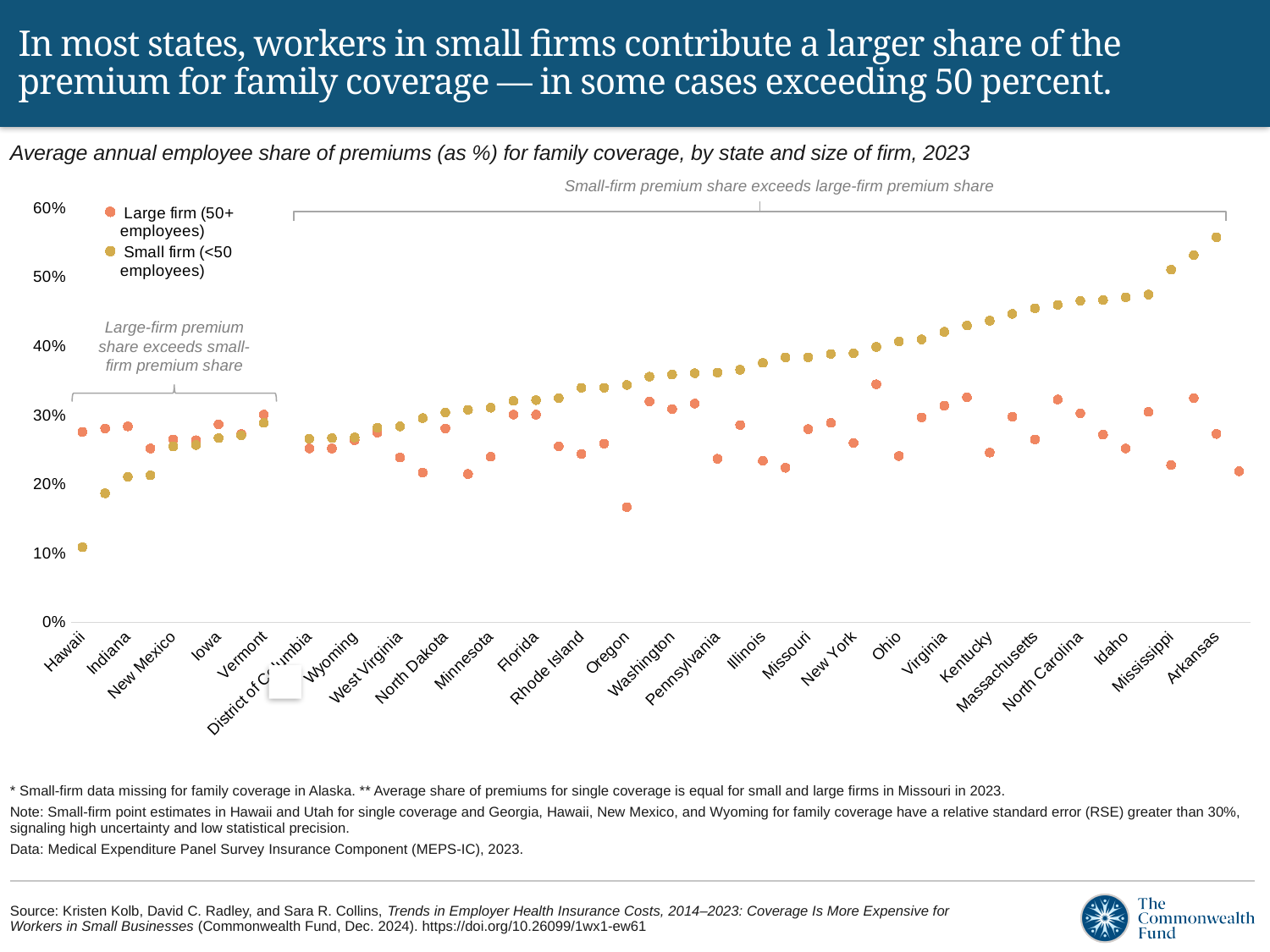
What does the annotation above the bracket spanning most of the chart say? Small-firm premium share exceeds large-firm premium share What kind of chart is shown on the slide? Scatter (dot) chart In Hawaii, which is larger: the large-firm premium share or the small-firm premium share? Large-firm premium share How many series does the legend list? 2 Is the small-firm premium share for Arkansas greater or less than 50%? greater Is the small-firm premium share for Hawaii greater or less than 20%? less Is the large-firm premium share for Arkansas greater or less than 30%? less What are the two series named in the legend? Large firm (50+ employees) and Small firm (<50 employees) Which state has the highest small-firm premium share? Arkansas Which state has the lowest small-firm premium share? Hawaii In Arkansas, which is larger: the large-firm premium share or the small-firm premium share? Small-firm premium share Do the small-firm premium share values rise or fall moving from left to right along the x axis? Rise